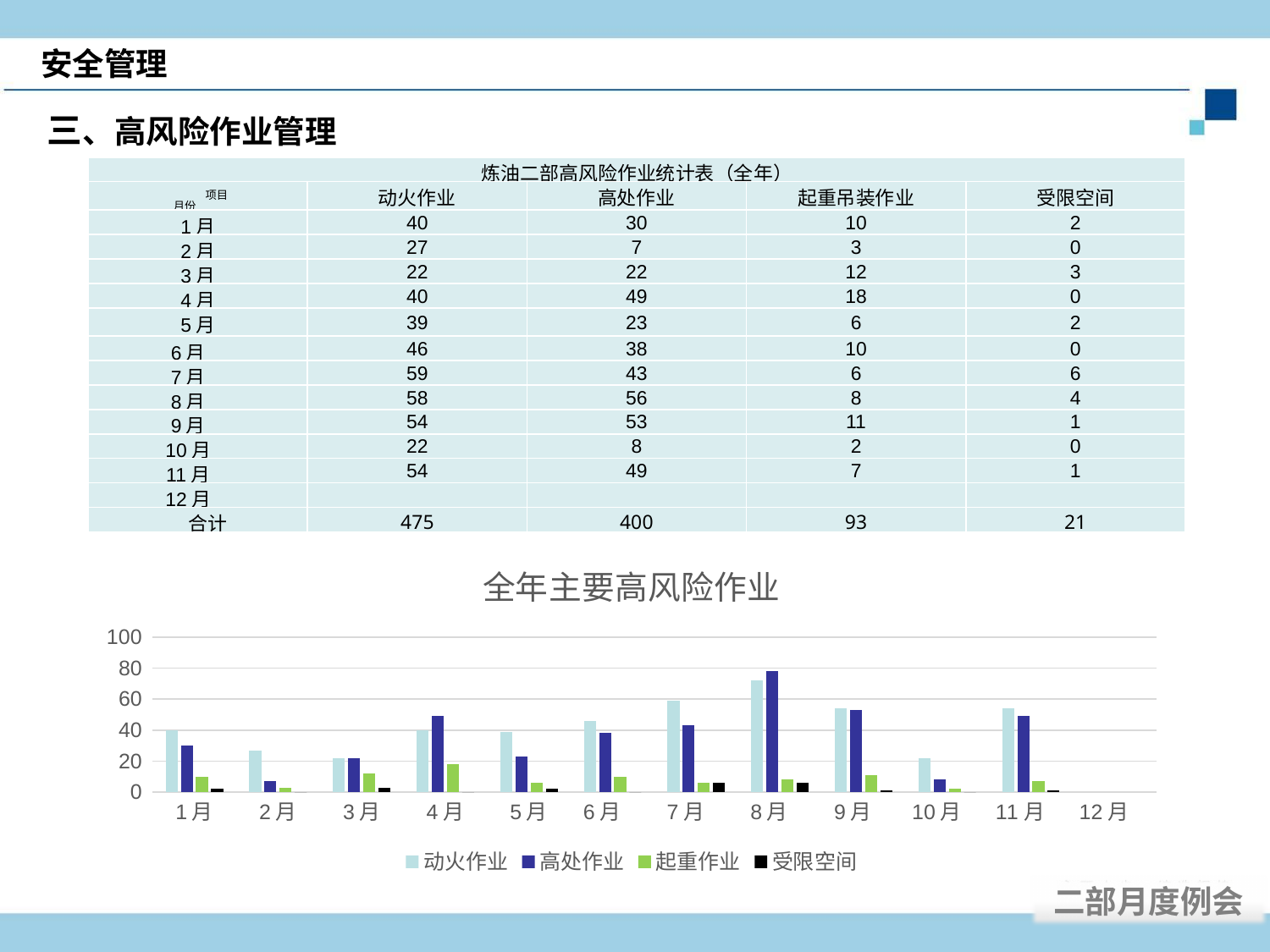
In the chart 全年主要高风险作业, is the value for 动火作业 in 8月 greater or less than 60? greater In the chart 全年主要高风险作业, is the value for 高处作业 in 2月 greater or less than 20? less In the chart 全年主要高风险作业, which month has the highest value for 高处作业? 8月 How many month categories are shown on the x axis of the chart 全年主要高风险作业? 12 What kind of chart is shown under the title 全年主要高风险作业? bar chart What is the title of the bar chart on the slide? 全年主要高风险作业 In the chart 全年主要高风险作业, which is larger in 4月: 动火作业 or 高处作业? 高处作业 In the chart 全年主要高风险作业, which month has the highest value for 起重作业? 4月 In the chart 全年主要高风险作业, is the value for 高处作业 in 4月 greater or less than 40? greater How many series does the legend of the chart 全年主要高风险作业 list? 4 In the chart 全年主要高风险作业, which is larger in 1月: 动火作业 or 高处作业? 动火作业 In the chart 全年主要高风险作业, which month has the highest value for 动火作业? 8月